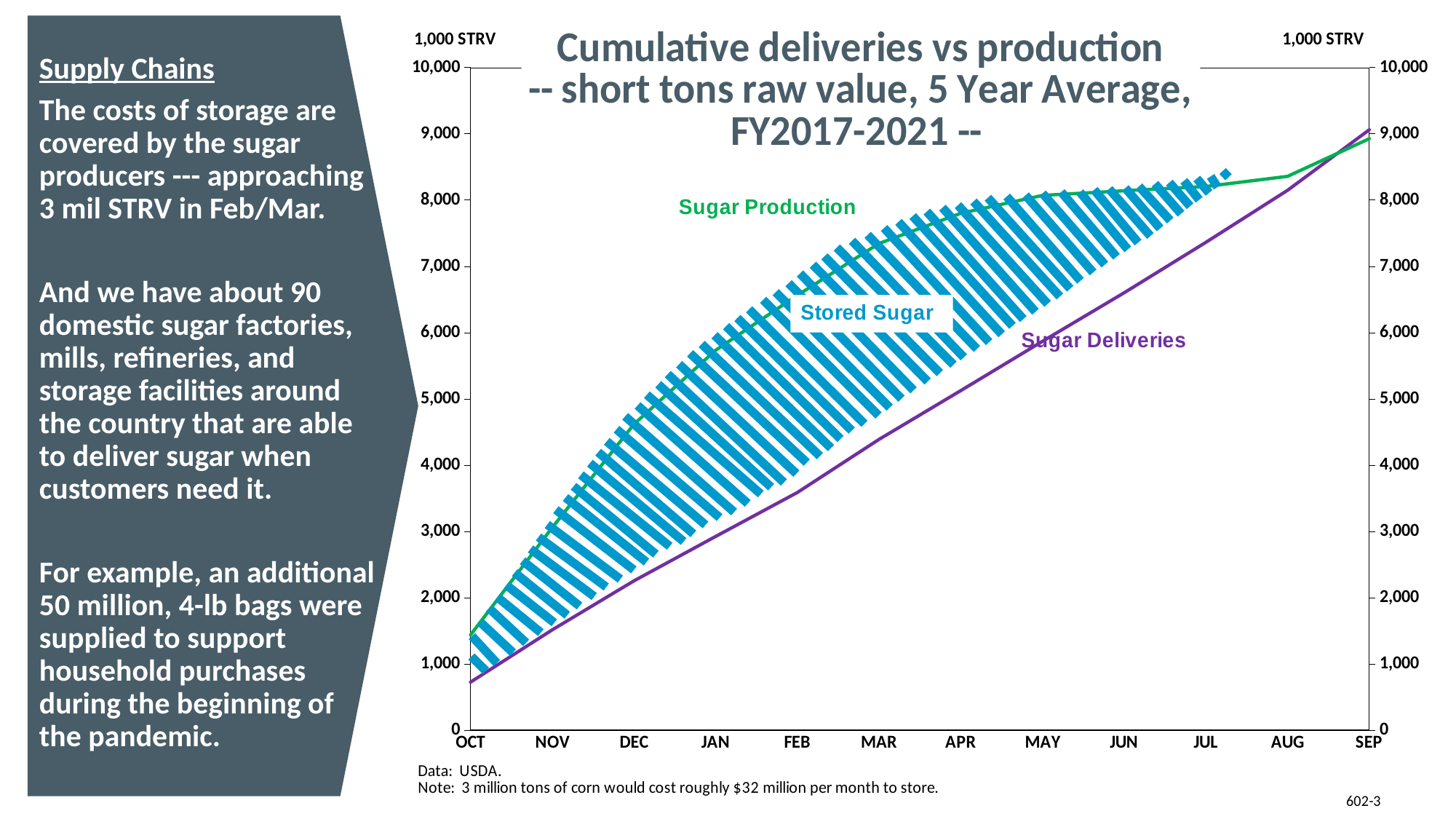
In which month is Sugar Deliveries at its lowest? OCT What kind of chart is shown on the slide? Line chart Is the value for Sugar Production in OCT greater or less than 1,000? greater How many data series are plotted as lines on the chart? 2 Is the value for Sugar Production in DEC greater or less than 4,000? greater Is the value for Sugar Deliveries in FEB greater or less than 3,000? greater In MAR, which is larger: Sugar Production or Sugar Deliveries? Sugar Production Does the Sugar Deliveries line rise or fall from OCT to SEP? Rises What does the blue hatched area between the two lines represent? Stored Sugar How many months are shown along the x axis of the chart? 12